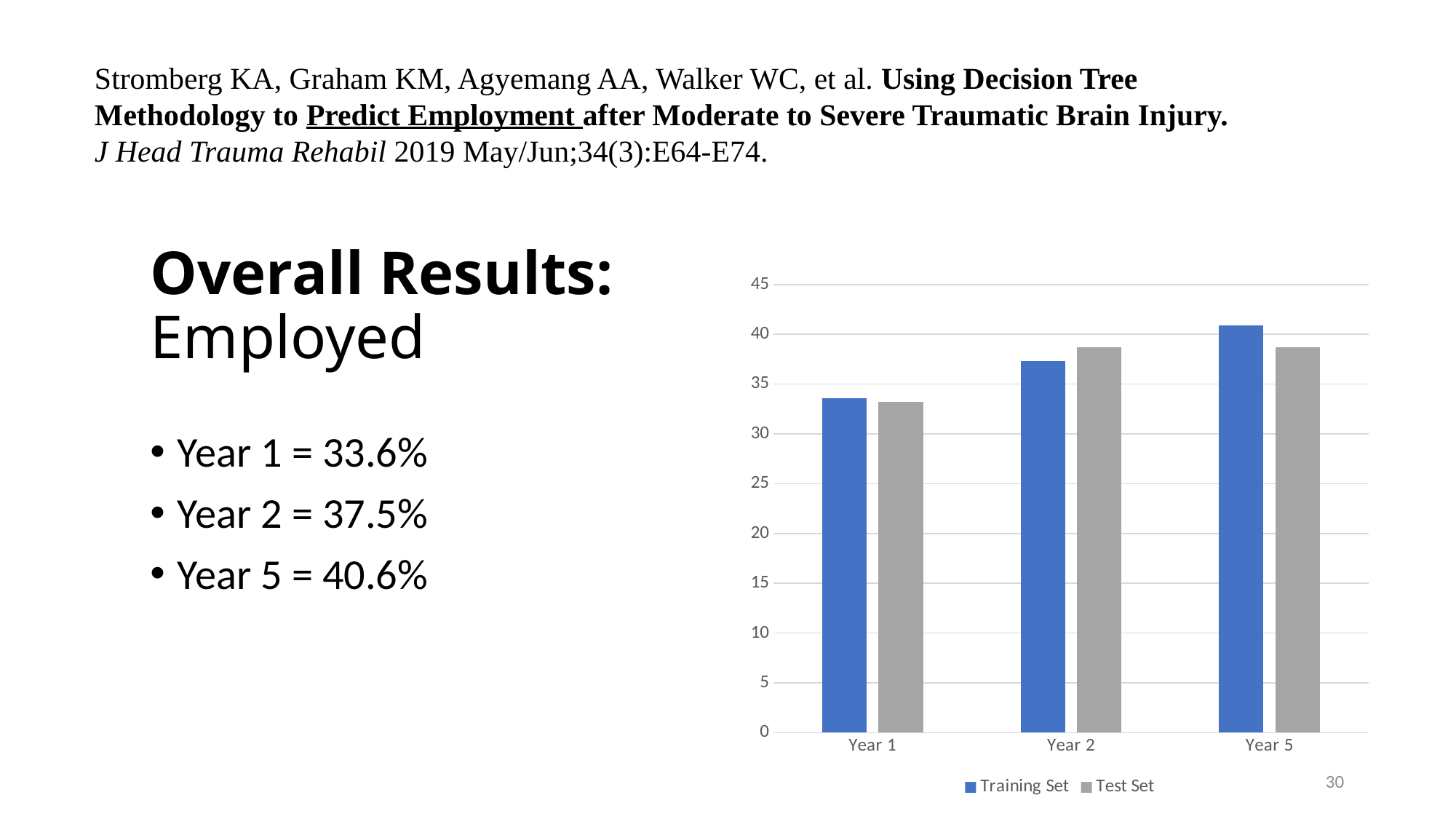
For Year 2, which is larger in the chart: the Training Set or the Test Set value? Test Set What kind of chart is shown on the slide? bar chart Is the Test Set value for Year 1 greater or less than 35? less Is the Training Set value for Year 5 greater or less than 40? greater How many series does the chart legend list? 2 Which category has the lowest Training Set value in the chart? Year 1 Which series is shown in blue in the chart? Training Set For Year 5, which is larger in the chart: the Training Set or the Test Set value? Training Set Which category has the lowest Test Set value in the chart? Year 1 Which category has the highest Training Set value in the chart? Year 5 Do the Training Set values rise or fall from Year 1 to Year 5 in the chart? rise How many categories are shown on the x axis of the chart? 3